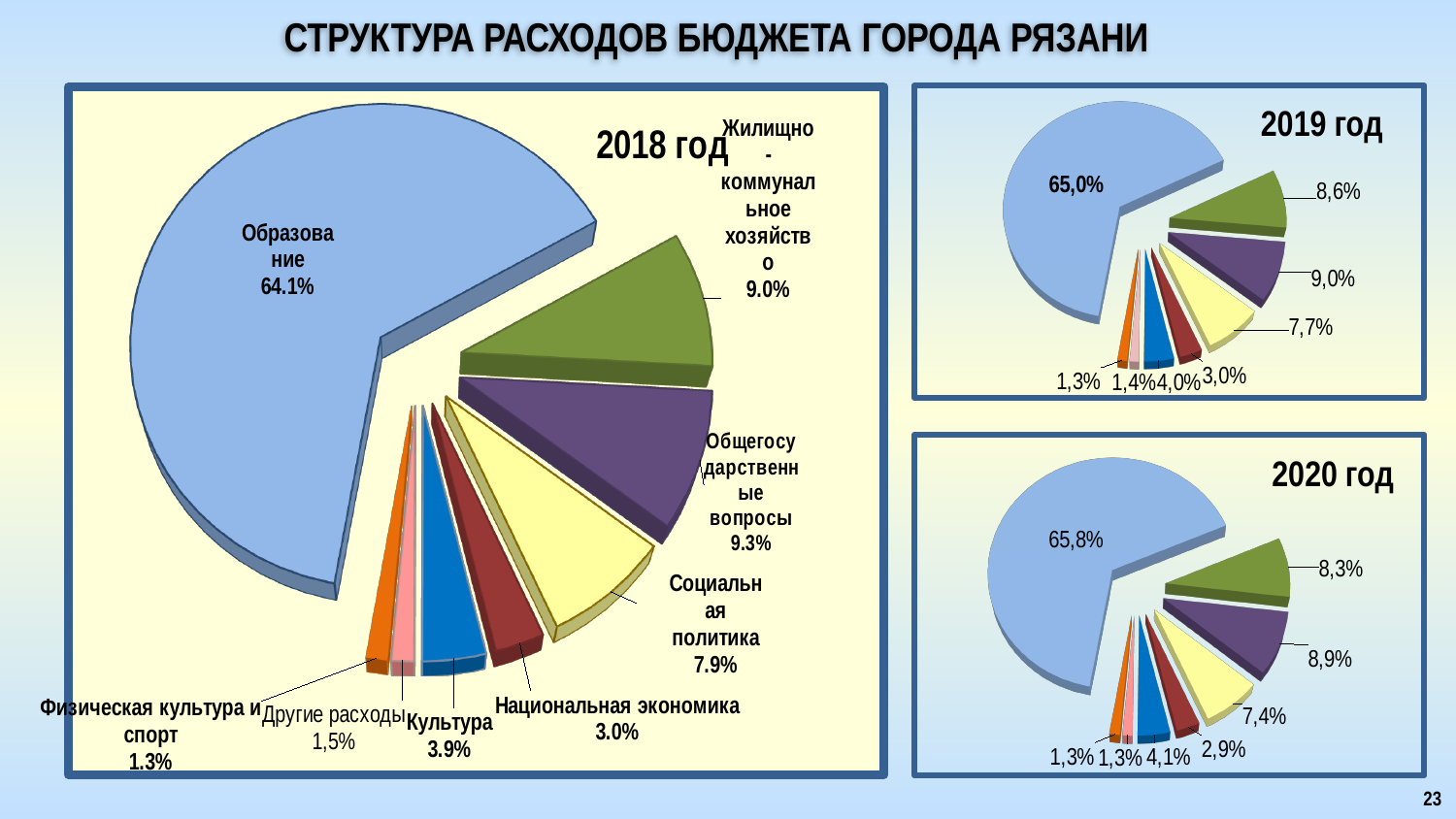
In the 2018 год pie chart, which is larger: Жилищно-коммунальное хозяйство or Общегосударственные вопросы? Общегосударственные вопросы In the 2018 год pie chart, what is the difference between the shares of Культура and Национальная экономика? 0.9% Which chart has the larger biggest slice: 2019 год or 2020 год? 2020 год In the 2018 год pie chart, what share is shown for Образование? 64.1% In the 2020 год pie chart, what is the value of the largest slice? 65,8% In the 2018 год pie chart, what share is shown for Социальная политика? 7.9% How many slices does the 2018 год pie chart have? 8 How many pie charts are shown on the slide? 3 In the 2019 год pie chart, what is the value of the largest slice? 65,0% In the 2018 год pie chart, which category has the smallest share? Физическая культура и спорт What type of chart is used for 2018 год? Pie chart In the 2018 год pie chart, which category has the largest share? Образование